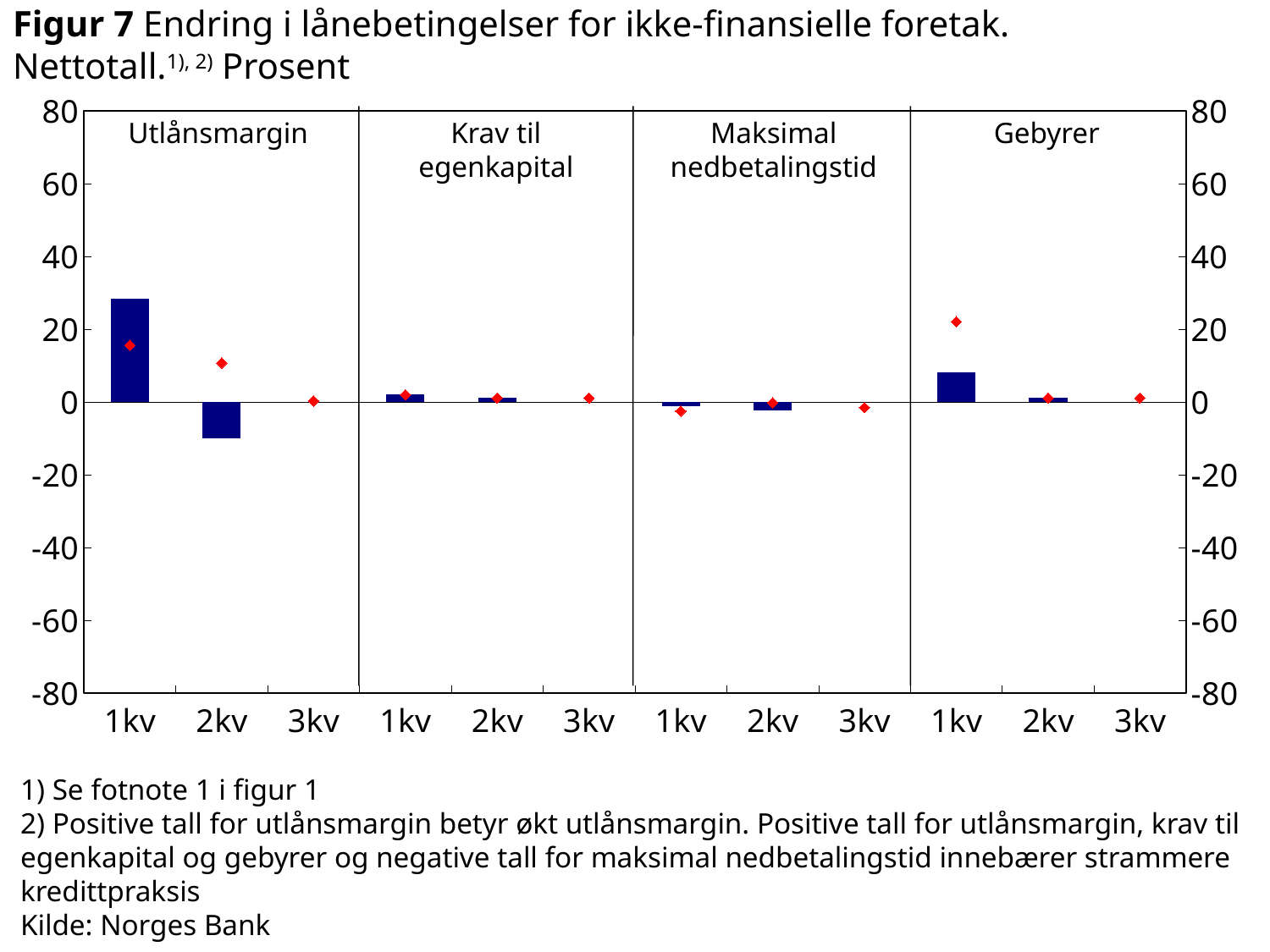
Is the bar for 2kv in the Utlånsmargin panel greater or less than 0? less What source is given for the chart? Norges Bank What kind of chart is shown on the slide? bar chart with red diamond markers (combination bar and line chart) Which is larger: the 1kv bar in the Utlånsmargin panel or the 1kv bar in the Gebyrer panel? Utlånsmargin 1kv How many quarters are shown on the x axis within each panel? 3 Is the bar for 1kv in the Utlånsmargin panel greater or less than 20? greater Which panel and quarter has the highest bar in the chart? Utlånsmargin, 1kv Which panel and quarter has the lowest bar in the chart? Utlånsmargin, 2kv Is the red diamond for 1kv in the Gebyrer panel greater or less than 10? greater Do the bars in the Utlånsmargin panel rise or fall from 1kv to 2kv? fall How many panels (categories of loan conditions) does the chart have? 4 What is the figure number and title of the chart? Figur 7 Endring i lånebetingelser for ikke-finansielle foretak. Nettotall. Prosent